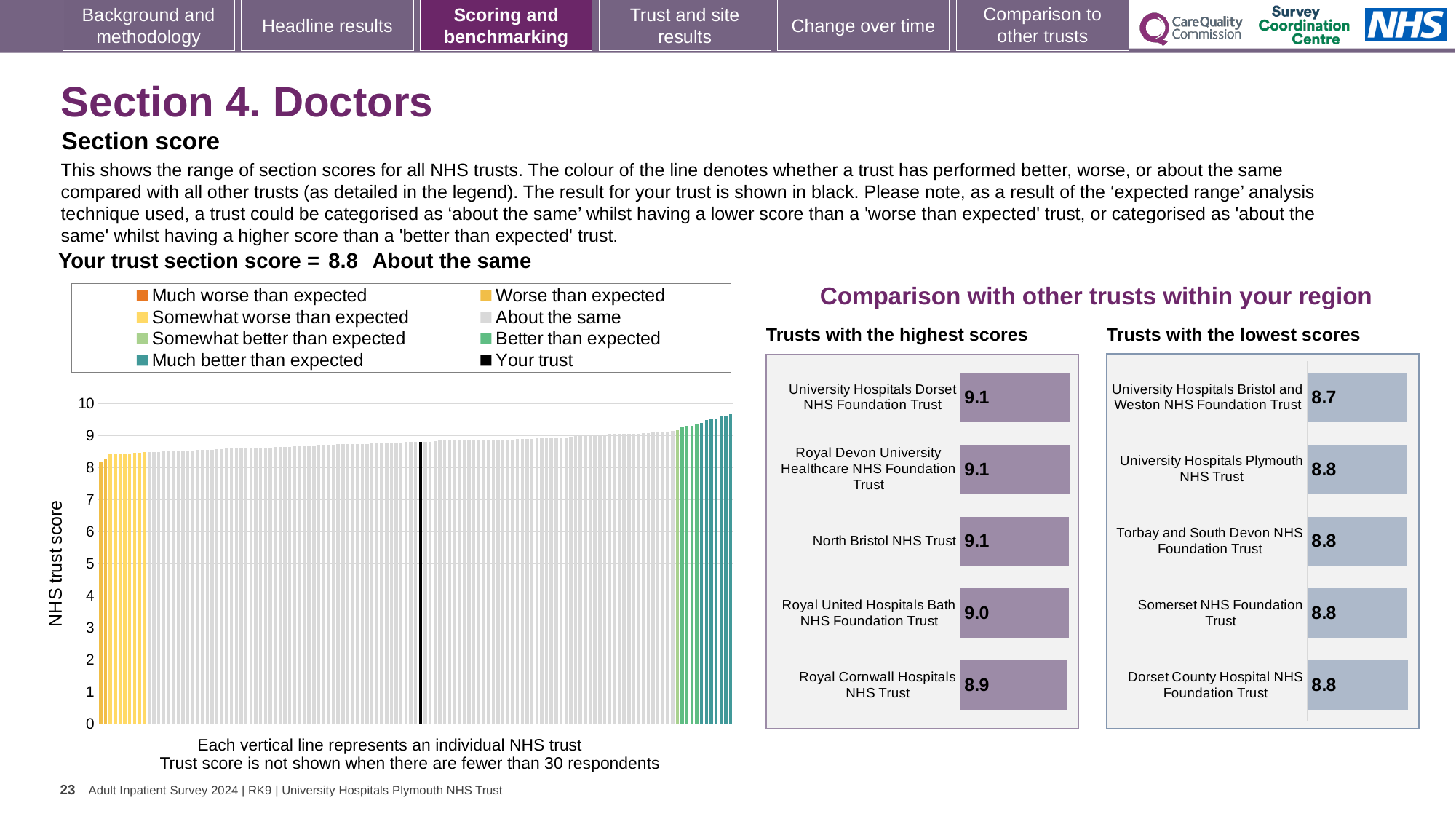
In the 'Trusts with the highest scores' chart, which has the larger score: Royal United Hospitals Bath NHS Foundation Trust or Royal Cornwall Hospitals NHS Trust? Royal United Hospitals Bath NHS Foundation Trust In the large chart on the left, is the value of the black bar (your trust) greater or less than 8? greater In the 'Trusts with the highest scores' chart, which trust has the lowest score? Royal Cornwall Hospitals NHS Trust How many trusts are listed in the 'Trusts with the lowest scores' chart? 5 In the 'Trusts with the lowest scores' chart, what is the score for University Hospitals Bristol and Weston NHS Foundation Trust? 8.7 In the 'Trusts with the highest scores' chart, what is the score for North Bristol NHS Trust? 9.1 In the large chart on the left, do the trust scores rise or fall from left to right? Rise What kind of chart is the large chart on the left showing NHS trust scores? Bar chart In the 'Trusts with the lowest scores' chart, which trust has the lowest score? University Hospitals Bristol and Weston NHS Foundation Trust In the 'Trusts with the highest scores' chart, what is the difference between the scores of University Hospitals Dorset NHS Foundation Trust and Royal Cornwall Hospitals NHS Trust? 0.2 How many entries does the legend of the large chart on the left list? 8 In the 'Trusts with the highest scores' chart, what is the score for Royal Cornwall Hospitals NHS Trust? 8.9